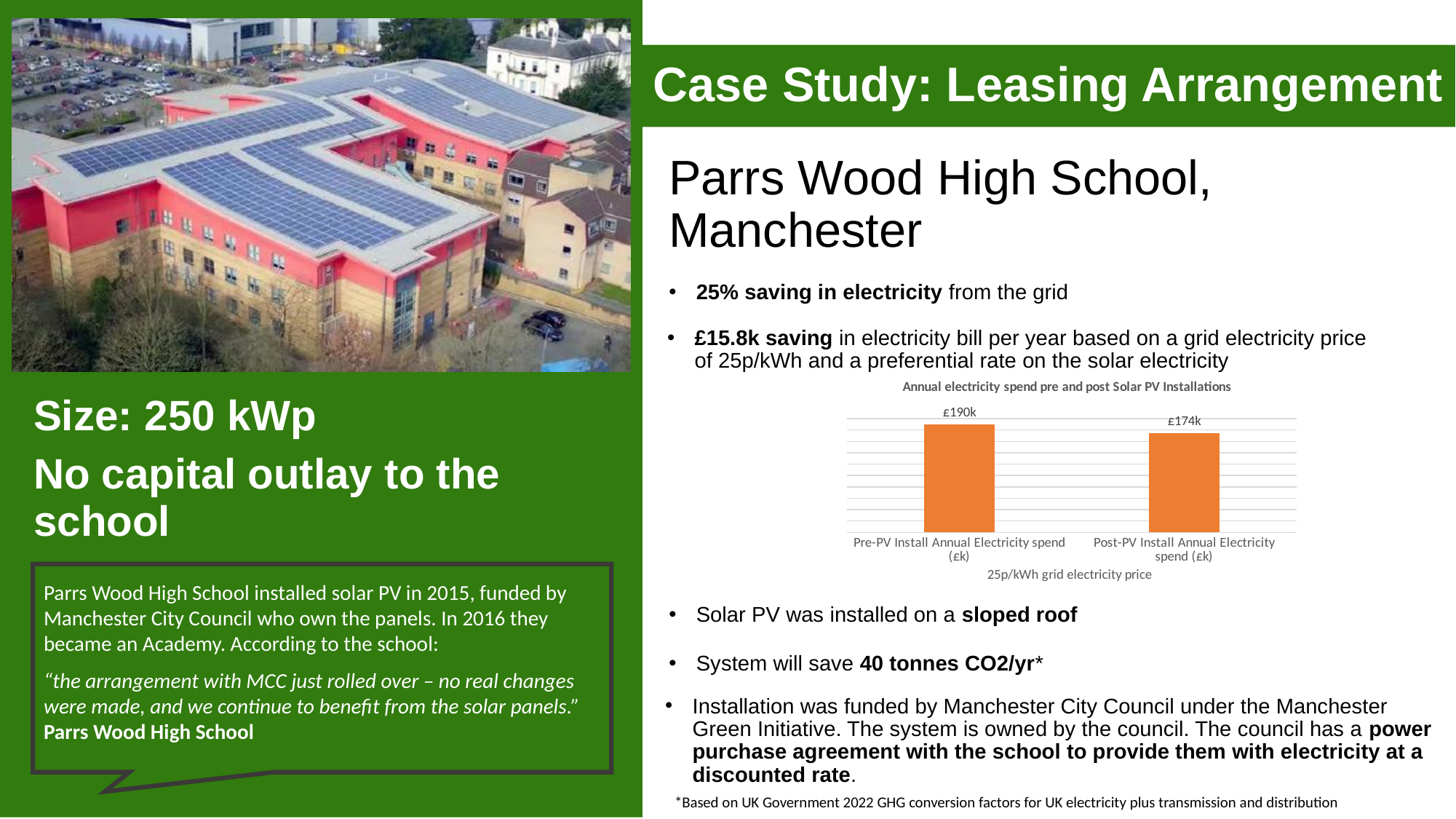
What type of chart is shown on the slide? bar chart Is the Pre-PV Install annual electricity spend larger or smaller than the Post-PV Install spend? larger Which category has the highest annual electricity spend? Pre-PV Install Annual Electricity spend (£k) How many bars are plotted in the chart? 2 What is the value of the Pre-PV Install Annual Electricity spend bar? £190k Do the values fall or rise from the Pre-PV bar to the Post-PV bar? fall Which category has the lowest annual electricity spend? Post-PV Install Annual Electricity spend (£k) What is the title of the chart? Annual electricity spend pre and post Solar PV Installations What grid electricity price is stated on the chart's horizontal axis label? 25p/kWh grid electricity price What is the difference between the Pre-PV and Post-PV annual electricity spend? £16k What is the value of the Post-PV Install Annual Electricity spend bar? £174k